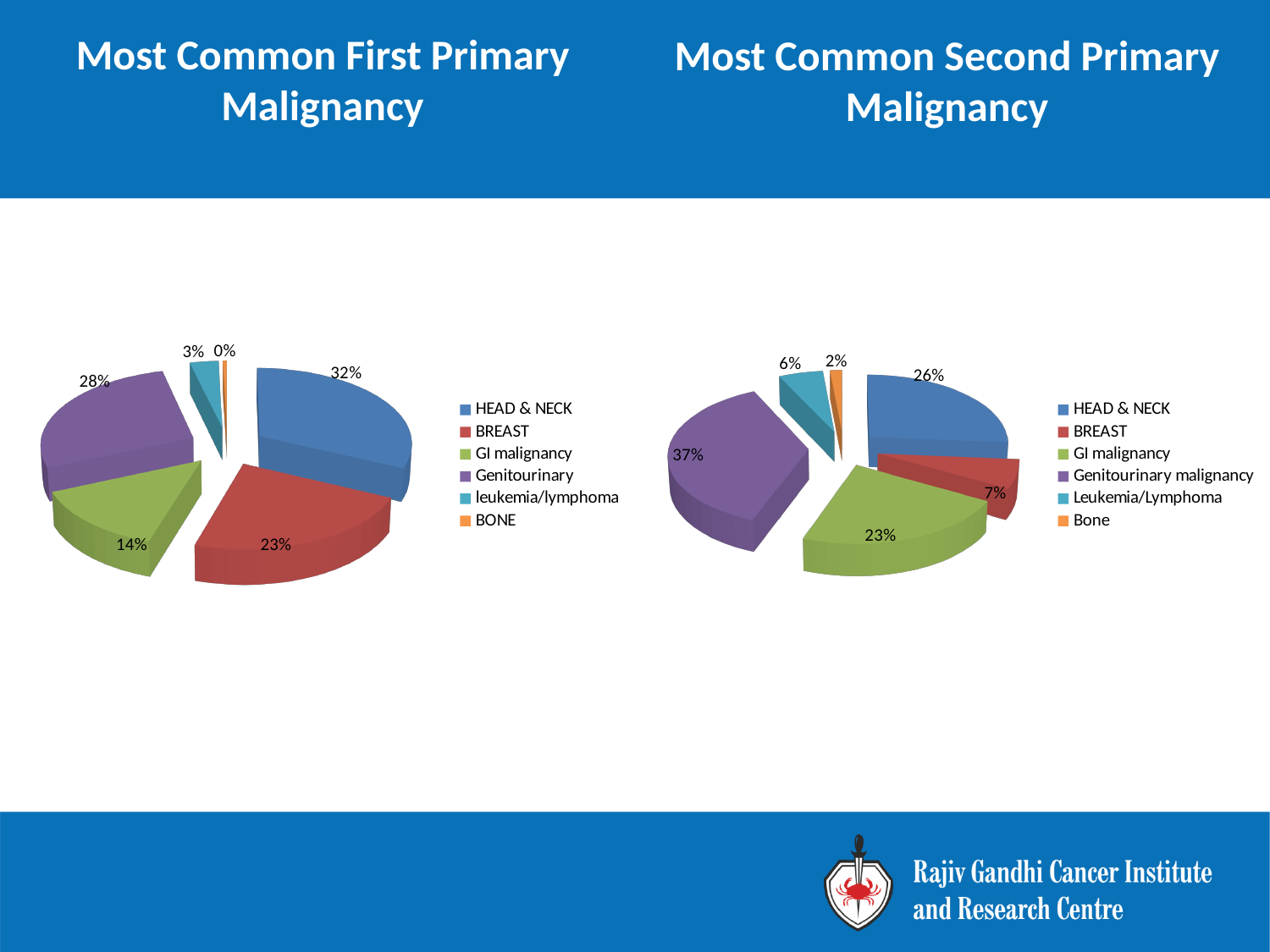
In the 'Most Common Second Primary Malignancy' chart, what is the difference between the Genitourinary malignancy and HEAD & NECK percentages? 11% In the 'Most Common First Primary Malignancy' chart, which category has the smallest share? BONE In the 'Most Common First Primary Malignancy' chart, what is the difference between the HEAD & NECK and Genitourinary percentages? 4% In the 'Most Common Second Primary Malignancy' chart, which category has the largest share? Genitourinary malignancy In the 'Most Common First Primary Malignancy' chart, what percentage is shown for GI malignancy? 14% In the 'Most Common First Primary Malignancy' chart, which category has the largest share? HEAD & NECK In the 'Most Common First Primary Malignancy' chart, what percentage is shown for HEAD & NECK? 32% In the 'Most Common Second Primary Malignancy' chart, what percentage is shown for BREAST? 7% In the 'Most Common Second Primary Malignancy' chart, what percentage is shown for Genitourinary malignancy? 37% What type of chart is used for 'Most Common Second Primary Malignancy'? Pie chart In the 'Most Common Second Primary Malignancy' chart, which is larger, HEAD & NECK or GI malignancy? HEAD & NECK How many categories does the legend of the 'Most Common First Primary Malignancy' chart list? 6